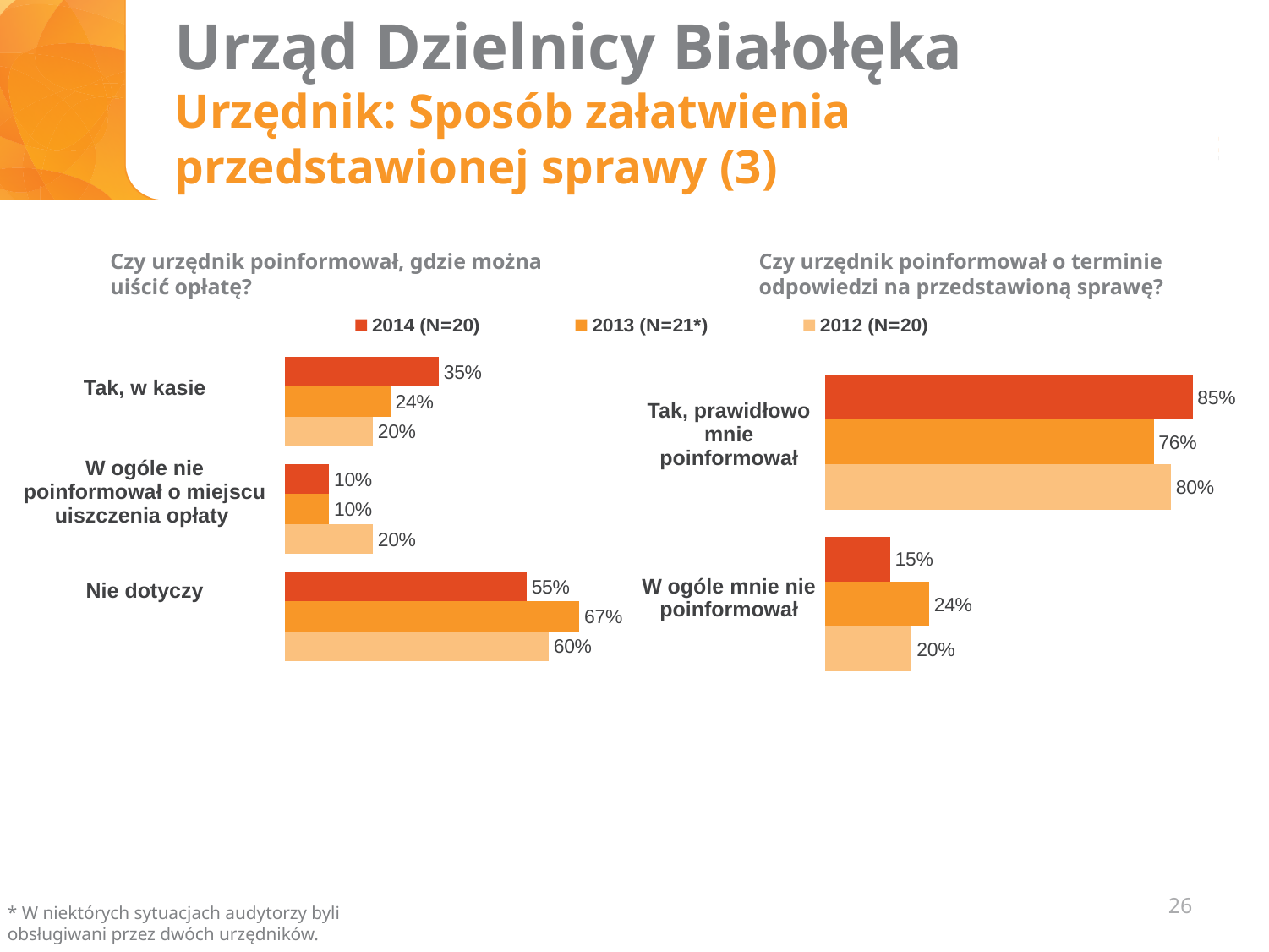
In the right chart ("Czy urzędnik poinformował o terminie odpowiedzi na przedstawioną sprawę?"), what is the value for "W ogóle mnie nie poinformował" in 2014 (N=20)? 15% How many categories does the left chart ("Czy urzędnik poinformował, gdzie można uiścić opłatę?") show? 3 In the left chart ("Czy urzędnik poinformował, gdzie można uiścić opłatę?"), what is the difference between the 2013 and 2014 values for "Nie dotyczy"? 12 percentage points In the left chart ("Czy urzędnik poinformował, gdzie można uiścić opłatę?"), what is the value for "Tak, w kasie" in 2014 (N=20)? 35% In the right chart ("Czy urzędnik poinformował o terminie odpowiedzi na przedstawioną sprawę?"), what is the value for "Tak, prawidłowo mnie poinformował" in 2012 (N=20)? 80% In the right chart ("Czy urzędnik poinformował o terminie odpowiedzi na przedstawioną sprawę?"), what is the difference between the 2014 and 2013 values for "Tak, prawidłowo mnie poinformował"? 9 percentage points In the left chart ("Czy urzędnik poinformował, gdzie można uiścić opłatę?"), which category has the highest value for 2014 (N=20)? Nie dotyczy In the left chart ("Czy urzędnik poinformował, gdzie można uiścić opłatę?"), what is the value for "Nie dotyczy" in 2013 (N=21*)? 67% How many series does the legend list for the charts on this slide? 3 What kind of chart is the right chart ("Czy urzędnik poinformował o terminie odpowiedzi na przedstawioną sprawę?")? Bar chart In the right chart ("Czy urzędnik poinformował o terminie odpowiedzi na przedstawioną sprawę?"), which year has the lowest value for "Tak, prawidłowo mnie poinformował"? 2013 (N=21*) In the left chart ("Czy urzędnik poinformował, gdzie można uiścić opłatę?"), which is larger for "Tak, w kasie": the 2014 value or the 2012 value? 2014 (35%)